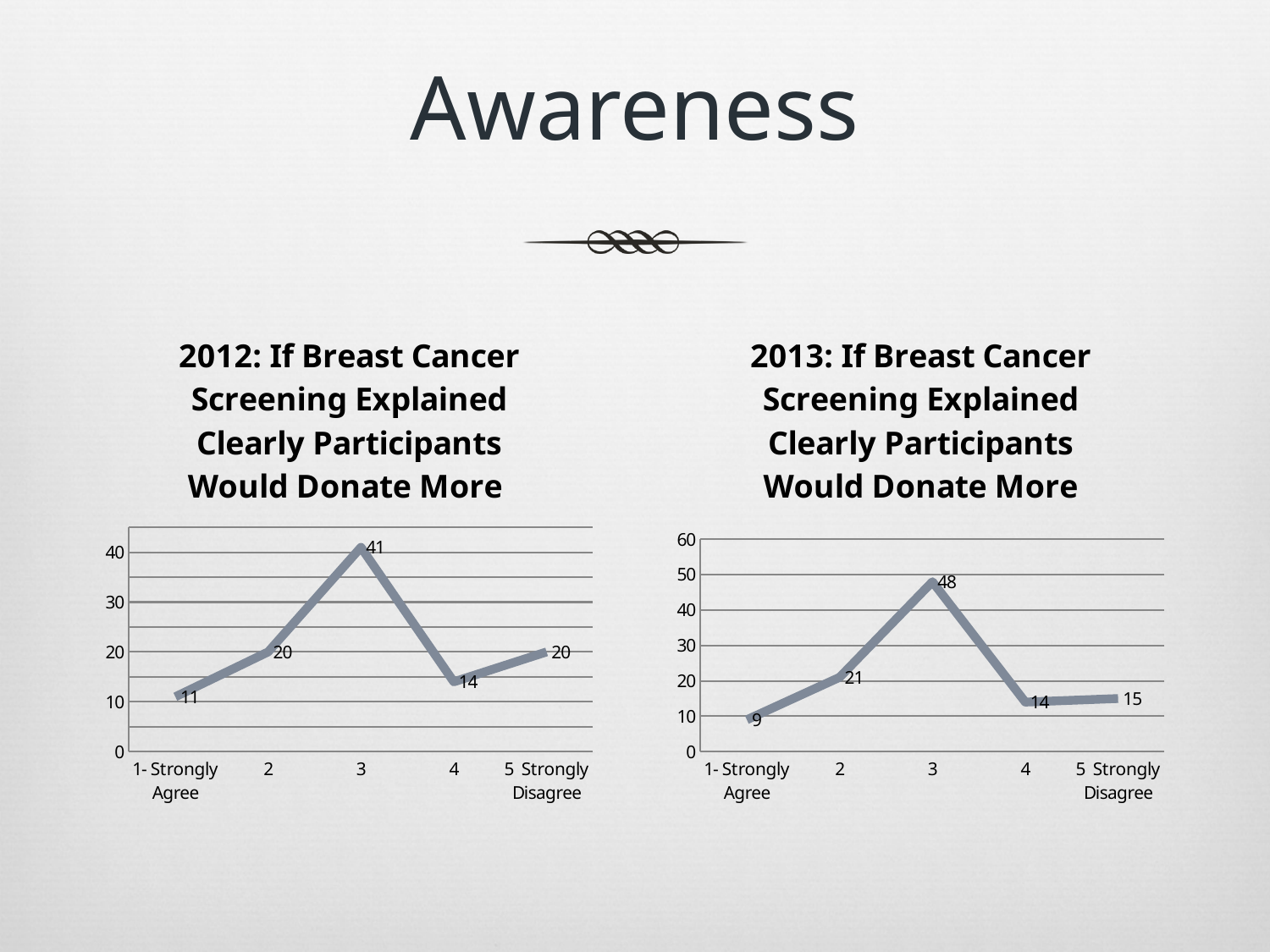
In the 2012 chart, which category has the lowest value? 1- Strongly Agree In the 2013 chart, what is the value for '1- Strongly Agree'? 9 In the 2013 chart, what is the difference between the values for category 3 and category 4? 34 In the 2013 chart, do the values rise or fall from category 3 to category 4? Fall In the 2012 chart, which is larger: the value for category 2 or the value for category 4? 2 In the 2012 chart, what is the value for '1- Strongly Agree'? 11 What kind of chart is the 2012 chart? Line chart How many categories are plotted on the x axis of the 2013 chart? 5 In the 2013 chart, what is the value for '5 Strongly Disagree'? 15 In the 2012 chart, what is the value for category 3? 41 In the 2013 chart, which category has the highest value? 3 In the 2012 chart, what is the difference between the values for category 3 and category 2? 21